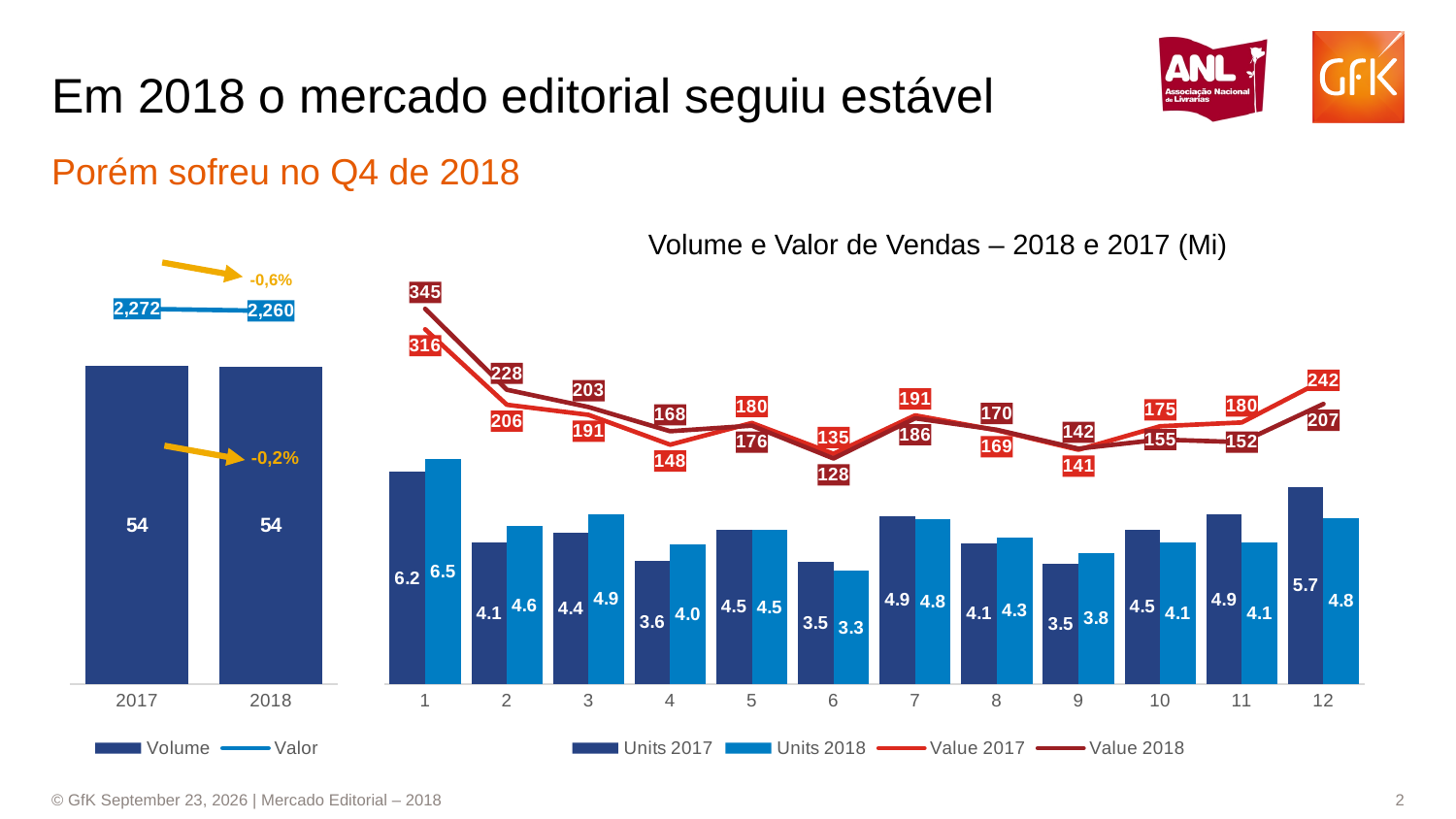
In the left chart, what is the Valor value for 2018? 2,260 In the chart titled 'Volume e Valor de Vendas – 2018 e 2017 (Mi)', which month has the lowest Units 2018 value? 6 In the left chart, what percentage change is annotated for Valor between 2017 and 2018? -0,6% In the chart titled 'Volume e Valor de Vendas – 2018 e 2017 (Mi)', what is the Units 2018 value for month 1? 6.5 How many months are shown on the x axis of the chart titled 'Volume e Valor de Vendas – 2018 e 2017 (Mi)'? 12 What kind of chart is the chart titled 'Volume e Valor de Vendas – 2018 e 2017 (Mi)'? Combined bar and line chart In the chart titled 'Volume e Valor de Vendas – 2018 e 2017 (Mi)', which is larger in month 10: Units 2017 or Units 2018? Units 2017 In the chart titled 'Volume e Valor de Vendas – 2018 e 2017 (Mi)', what is the Units 2017 value for month 12? 5.7 In the chart titled 'Volume e Valor de Vendas – 2018 e 2017 (Mi)', which month has the highest Units 2018 value? 1 How many series does the legend of the chart titled 'Volume e Valor de Vendas – 2018 e 2017 (Mi)' list? 4 In the chart titled 'Volume e Valor de Vendas – 2018 e 2017 (Mi)', what is the difference between Units 2018 and Units 2017 in month 1? 0.3 In the left chart, what is the Volume value for 2017? 54